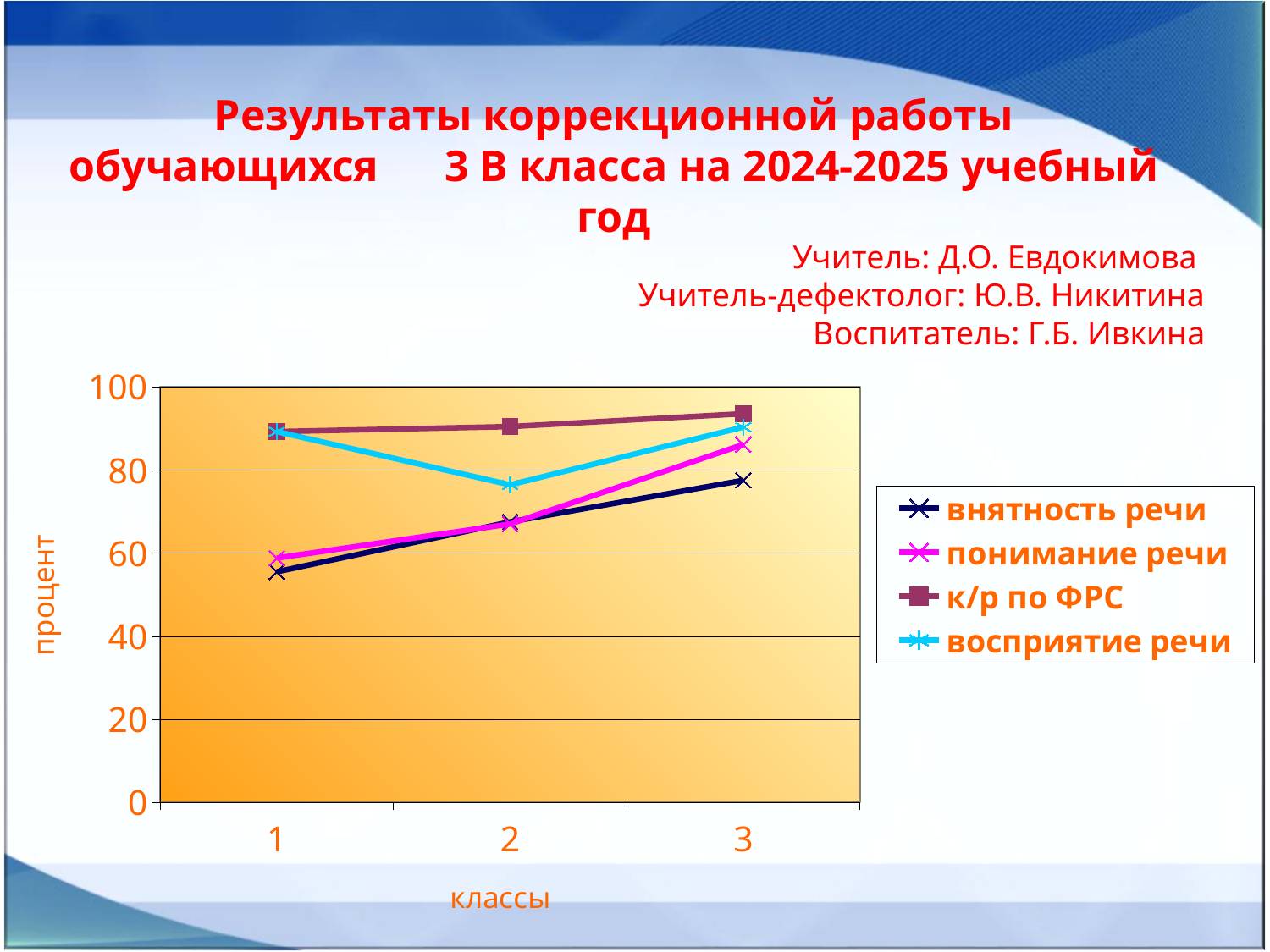
Is the value for понимание речи at class 3 greater or less than 80? greater Which series has the lowest value at class 3? внятность речи What kind of chart is shown on the slide? line chart Is the value for восприятие речи at class 2 greater or less than 80? less How many points are plotted along the x axis (классы)? 3 Is the value for к/р по ФРС at class 3 greater or less than 80? greater At class 2, which is larger: восприятие речи or внятность речи? восприятие речи What is the title of the vertical axis? процент How many series does the legend list? 4 Does the value for внятность речи rise or fall from class 1 to class 3? rise What is the title of the horizontal axis? классы